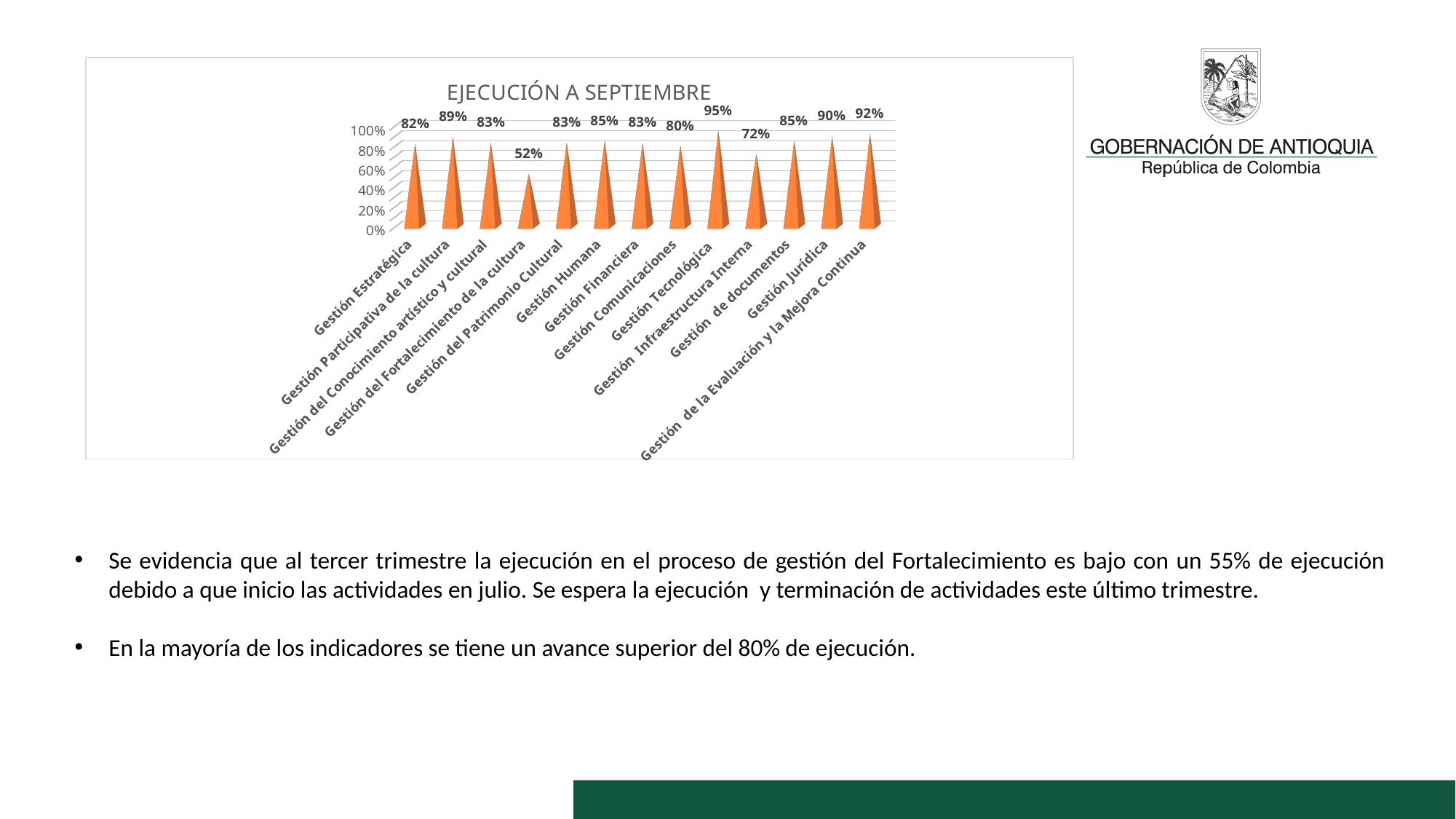
What is the value for Gestión Infraestructura Interna? 72% What is the title of the chart? EJECUCIÓN A SEPTIEMBRE What is the value for Gestión del Fortalecimiento de la cultura? 52% Which is larger, the value for Gestión Participativa de la cultura or the value for Gestión Estratégica? Gestión Participativa de la cultura How many categories are shown in the chart? 13 What is the value for Gestión Tecnológica in the EJECUCIÓN A SEPTIEMBRE chart? 95% Is the value for Gestión Infraestructura Interna greater or less than 80%? less What is the value for Gestión Jurídica? 90% Which category has the lowest value in the chart? Gestión del Fortalecimiento de la cultura What is the difference between the values for Gestión Tecnológica and Gestión del Fortalecimiento de la cultura? 43% Which category has the highest value in the chart? Gestión Tecnológica What kind of chart is shown on the slide? bar chart